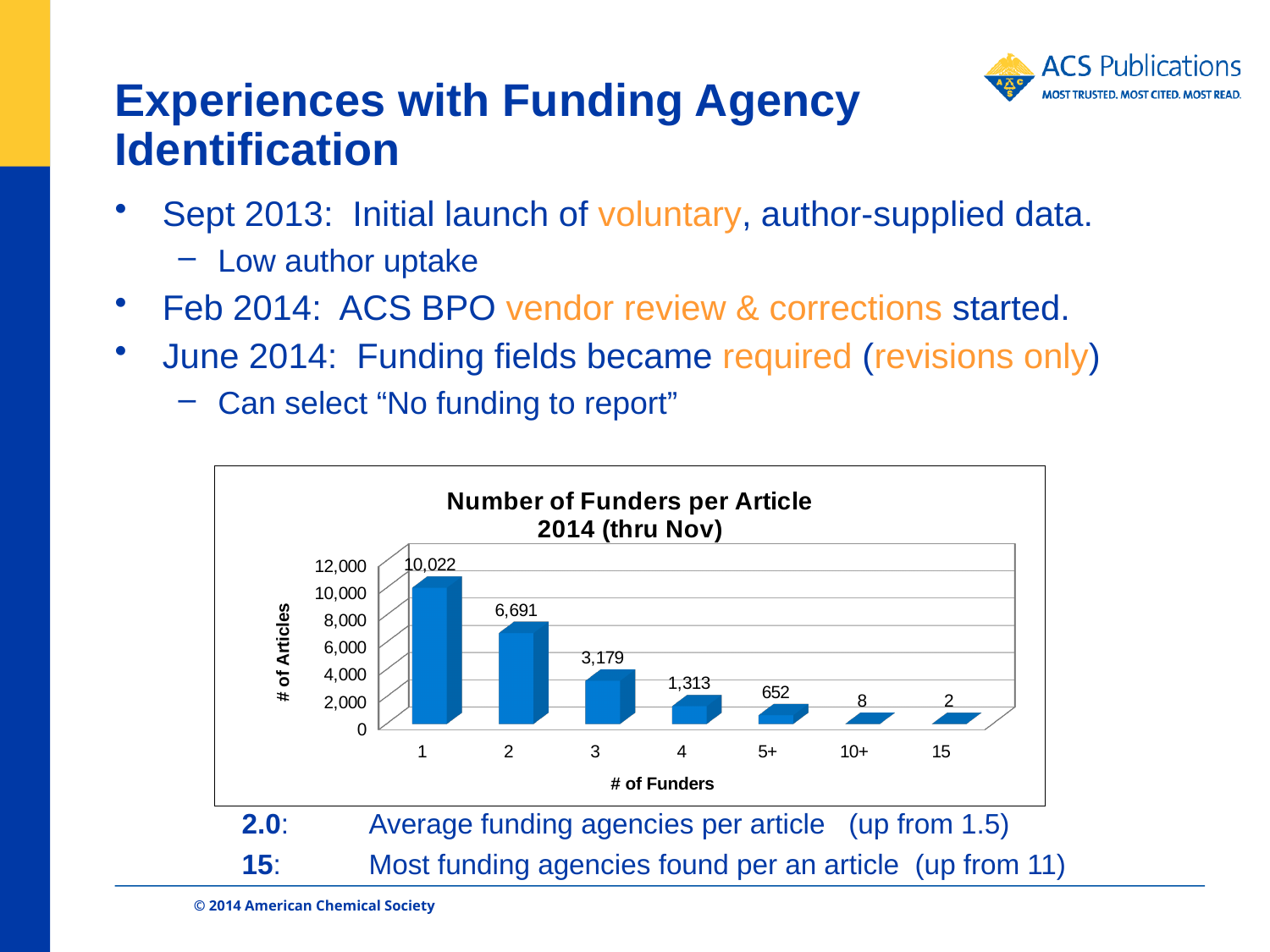
What is the number of articles with 1 funder? 10,022 Which number-of-funders category has the highest number of articles? 1 What is the number of articles with 15 funders? 2 What kind of chart is shown on the slide? Bar chart How many categories are shown on the x axis of the chart? 7 Do the values rise or fall as the number of funders increases along the x axis? Fall What is the number of articles with 5+ funders? 652 Which has more articles: 4 funders or 10+ funders? 4 funders What is the difference in number of articles between the 1-funder and 2-funder categories? 3,331 Which number-of-funders category has the lowest number of articles? 15 What is the title of the chart? Number of Funders per Article 2014 (thru Nov) What is the number of articles with 3 funders? 3,179